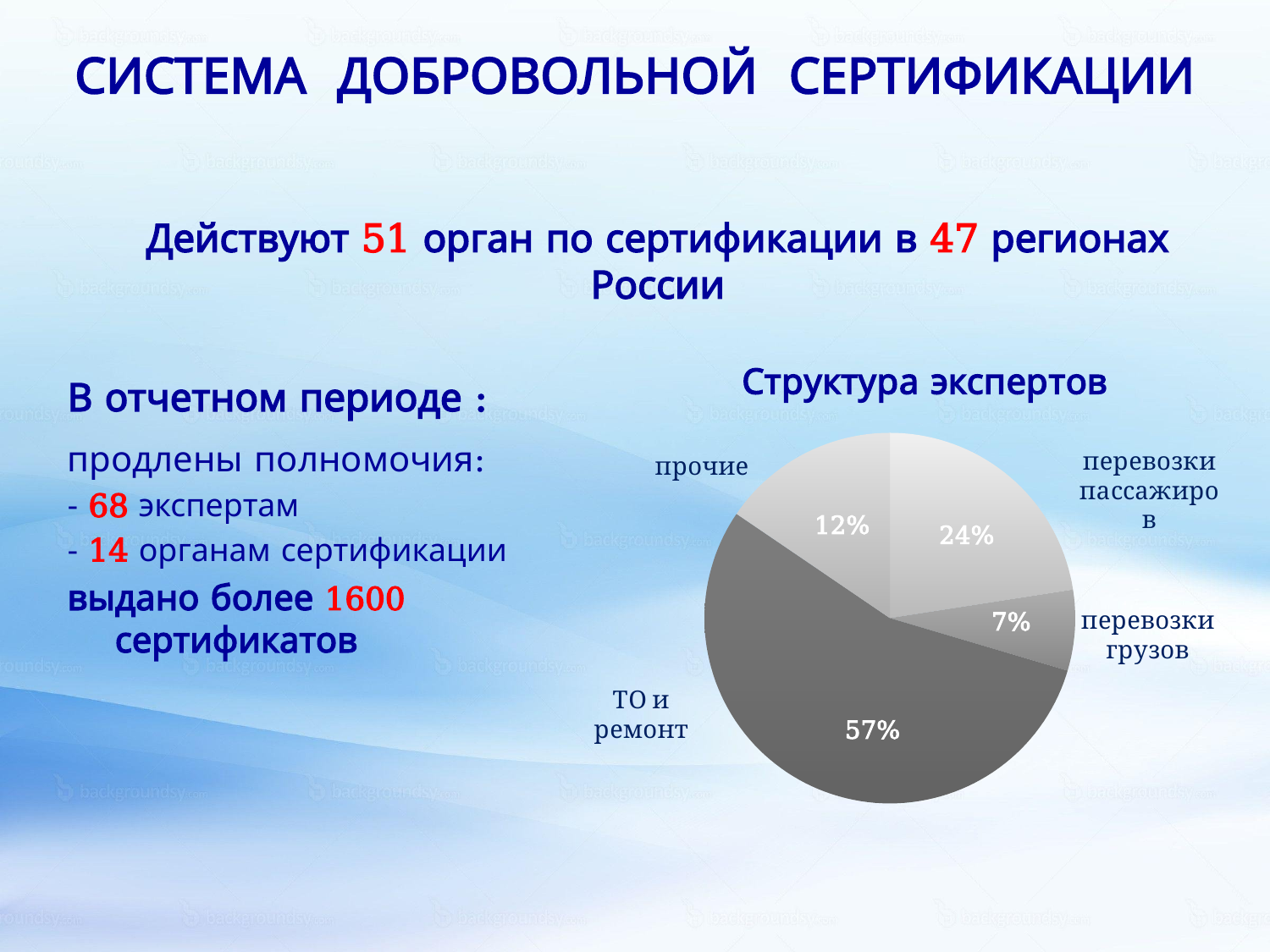
What share of the pie does "перевозки пассажиров" have? 24% Which category has the largest slice of the pie? ТО и ремонт What share of the pie does "прочие" have? 12% How many slices does the pie chart have? 4 Which category has the smallest slice of the pie? перевозки грузов What share of the pie does "ТО и ремонт" have? 57% What is the difference between the shares of "ТО и ремонт" and "перевозки пассажиров"? 33% What is the title of the chart on the slide? Структура экспертов What is the difference between the shares of "прочие" and "перевозки грузов"? 5% Which is larger, the share of "прочие" or the share of "перевозки грузов"? прочие What kind of chart is shown under the title "Структура экспертов"? pie chart